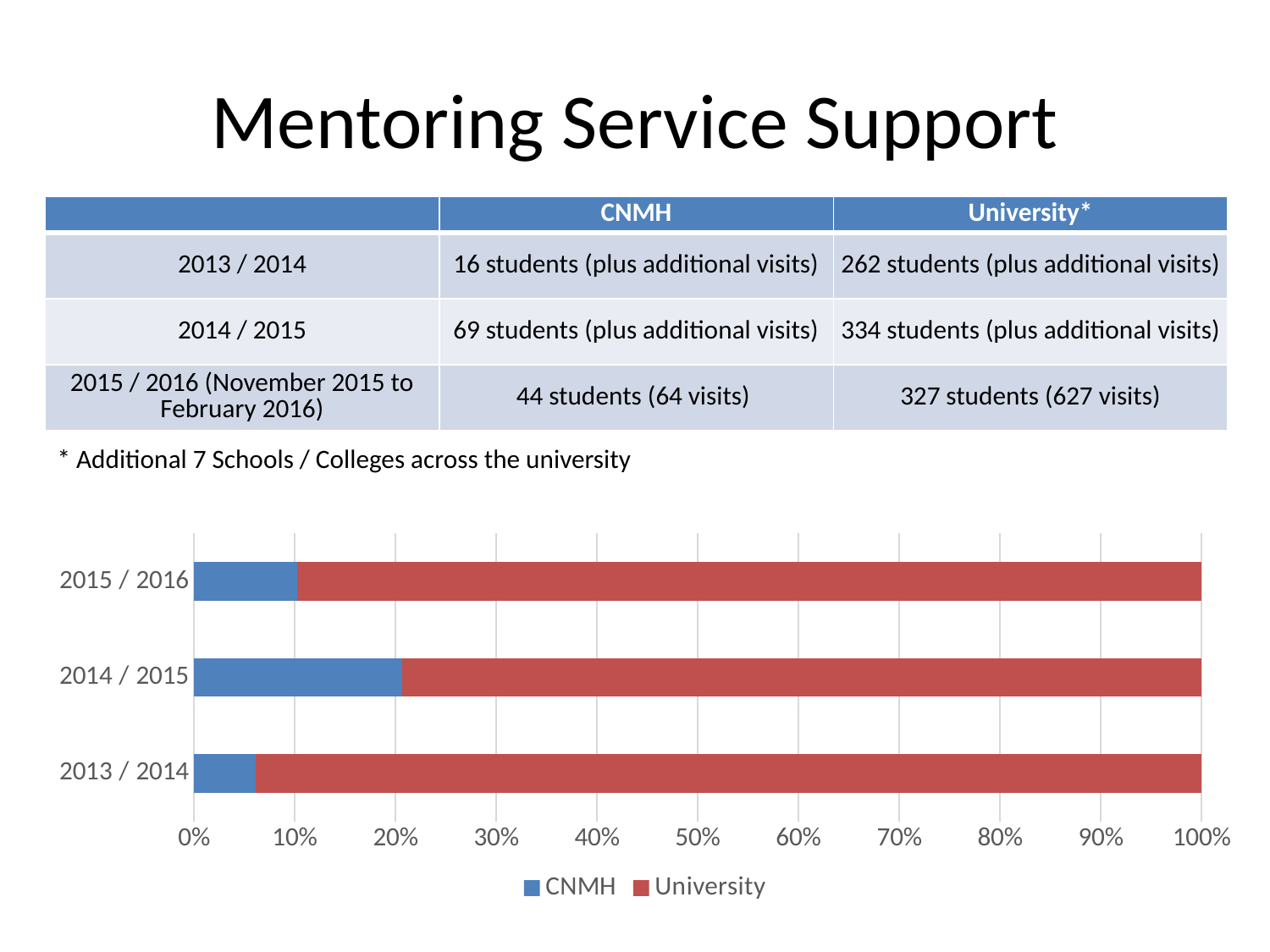
How many year categories are plotted on the chart? 3 Is the CNMH share for 2015 / 2016 greater or less than 20%? less Which series is shown in blue in the chart? CNMH Is the CNMH share for 2013 / 2014 greater or less than 10%? less What is the total of the stacked bar for 2013 / 2014? 100% In which year does CNMH take up the largest share of the bar? 2014 / 2015 Is the CNMH share for 2014 / 2015 greater or less than 10%? greater In which year does CNMH take up the smallest share of the bar? 2013 / 2014 Which series is shown in red in the chart? University Which is larger, the CNMH share for 2014 / 2015 or for 2013 / 2014? 2014 / 2015 How many series does the chart legend list? 2 What kind of chart is shown on the slide? bar chart